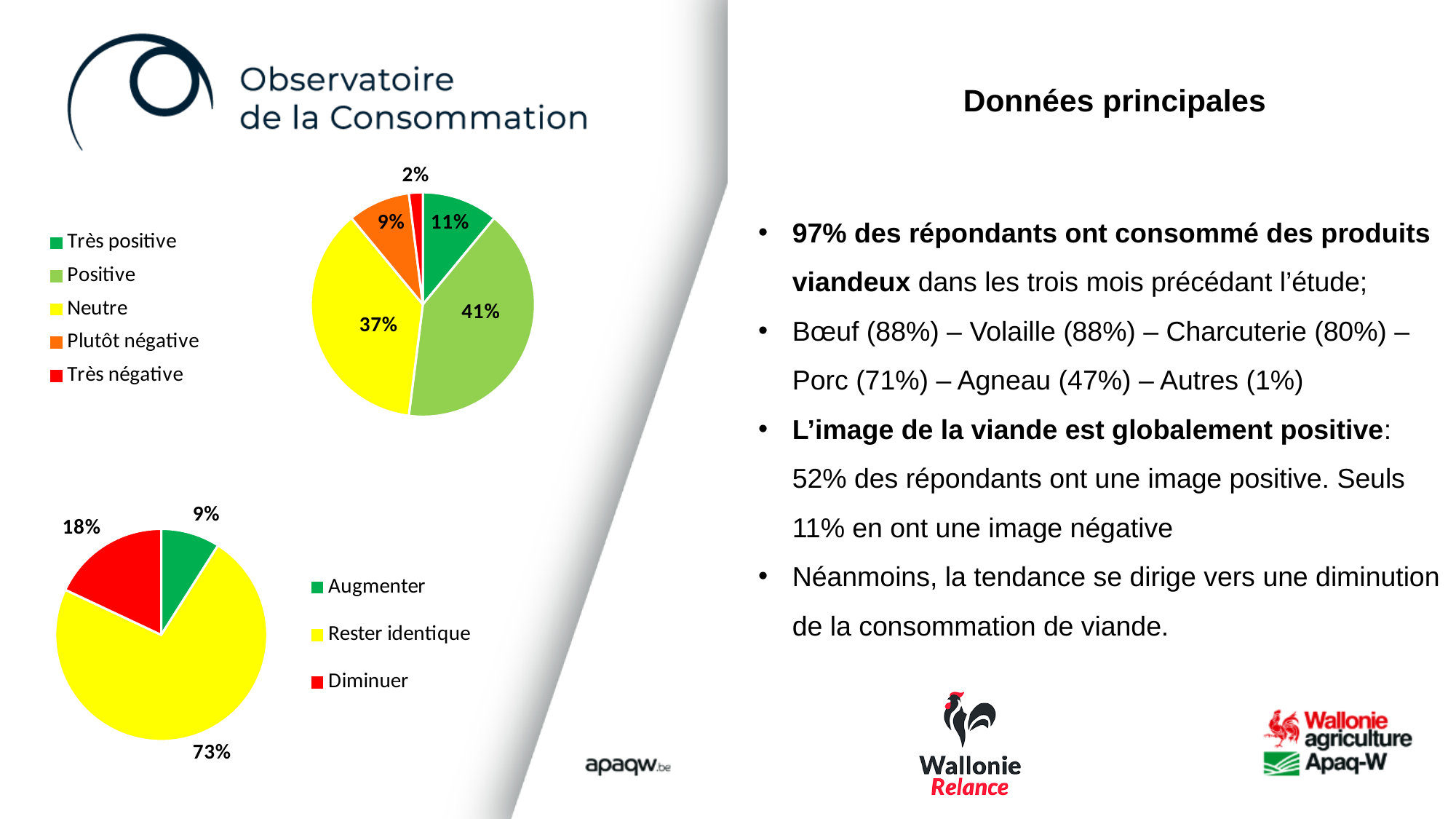
In the bottom pie chart, which is larger, 'Augmenter' or 'Diminuer'? Diminuer In the top pie chart, what percentage is shown for 'Neutre'? 37% In the top pie chart, which category has the largest share? Positive In the top pie chart, how many categories does the legend list? 5 What type of chart is the bottom chart on the slide? Pie chart In the top pie chart, which category has the smallest share? Très négative In the bottom pie chart, what is the difference between 'Diminuer' and 'Augmenter'? 9% In the bottom pie chart, what percentage is shown for 'Rester identique'? 73% In the bottom pie chart, what percentage is shown for 'Diminuer'? 18% In the top pie chart, what is the difference between the 'Positive' and 'Neutre' shares? 4% In the top pie chart, what percentage is shown for 'Très négative'? 2% In the top pie chart, what percentage is shown for 'Positive'? 41%